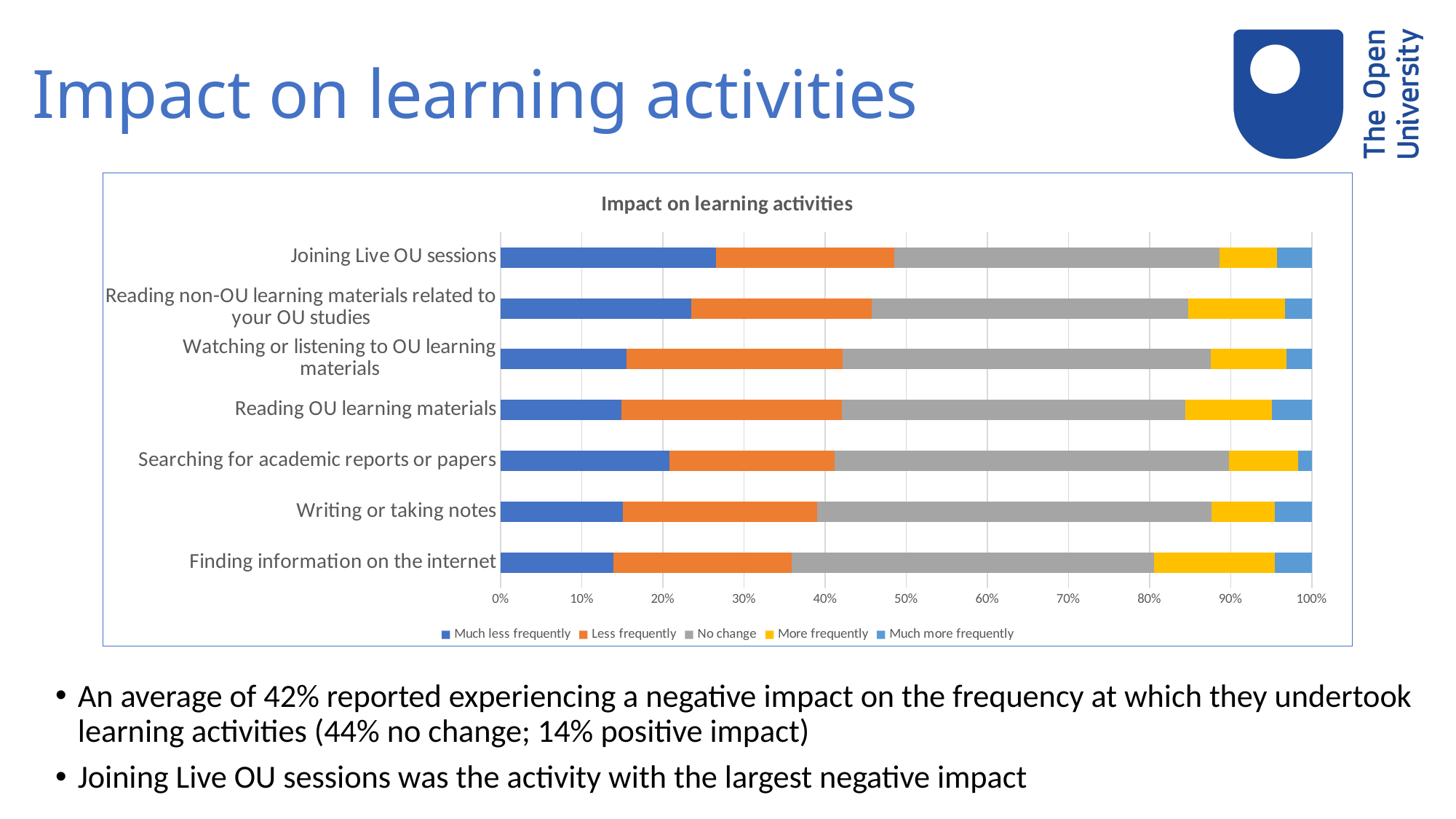
How many series does the chart legend list? 5 Is the combined 'Much less frequently' and 'Less frequently' share for Finding information on the internet greater or less than 40%? less Which has the larger 'Much less frequently' segment: Joining Live OU sessions or Finding information on the internet? Joining Live OU sessions How many learning activities (categories) are plotted in the chart? 7 Is the combined 'Much less frequently' and 'Less frequently' share for Joining Live OU sessions greater or less than 40%? greater Which colour represents 'No change' in the chart legend? Grey Which activity has the largest 'Much less frequently' segment? Joining Live OU sessions What is the title of the chart? Impact on learning activities Which activity has the largest 'More frequently' segment? Finding information on the internet What kind of chart is shown on the slide? Stacked bar chart Is the 'Much less frequently' share for Finding information on the internet greater or less than 20%? less